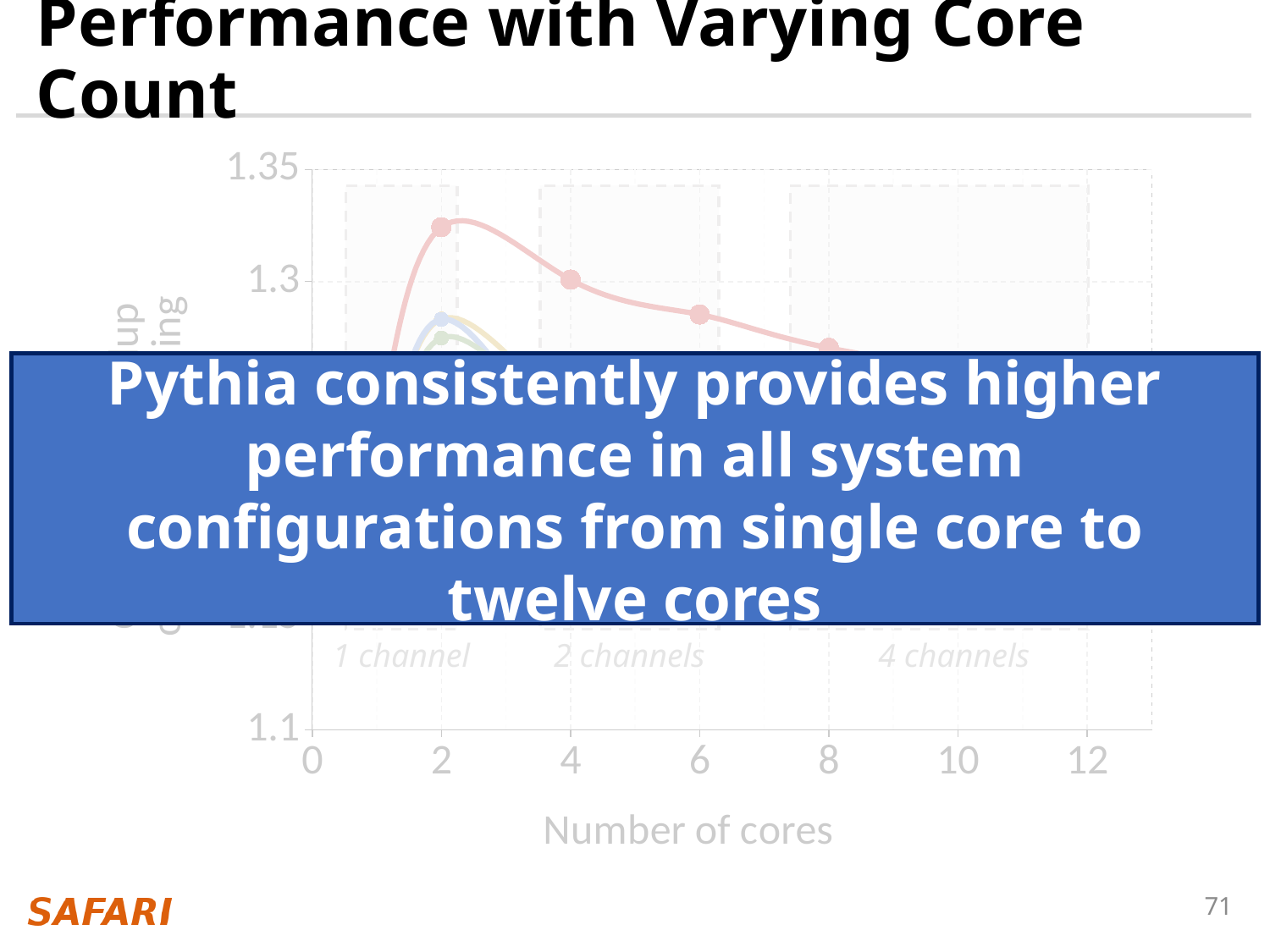
Is the value of the red (topmost) line at 8 cores greater or less than 1.3? less Is the value of the red (topmost) line at 2 cores greater or less than 1.3? greater What is the label of the x axis of the chart? Number of cores Does the red (topmost) line rise or fall as the number of cores increases from 2 to 8? fall Is the value of the red (topmost) line at 6 cores greater or less than 1.3? less What is the highest value shown on the y axis of the chart? 1.35 Which has the higher value on the red (topmost) line: 2 cores or 8 cores? 2 cores What kind of chart is shown on the slide? line chart What is the largest number of cores shown on the x axis of the chart? 12